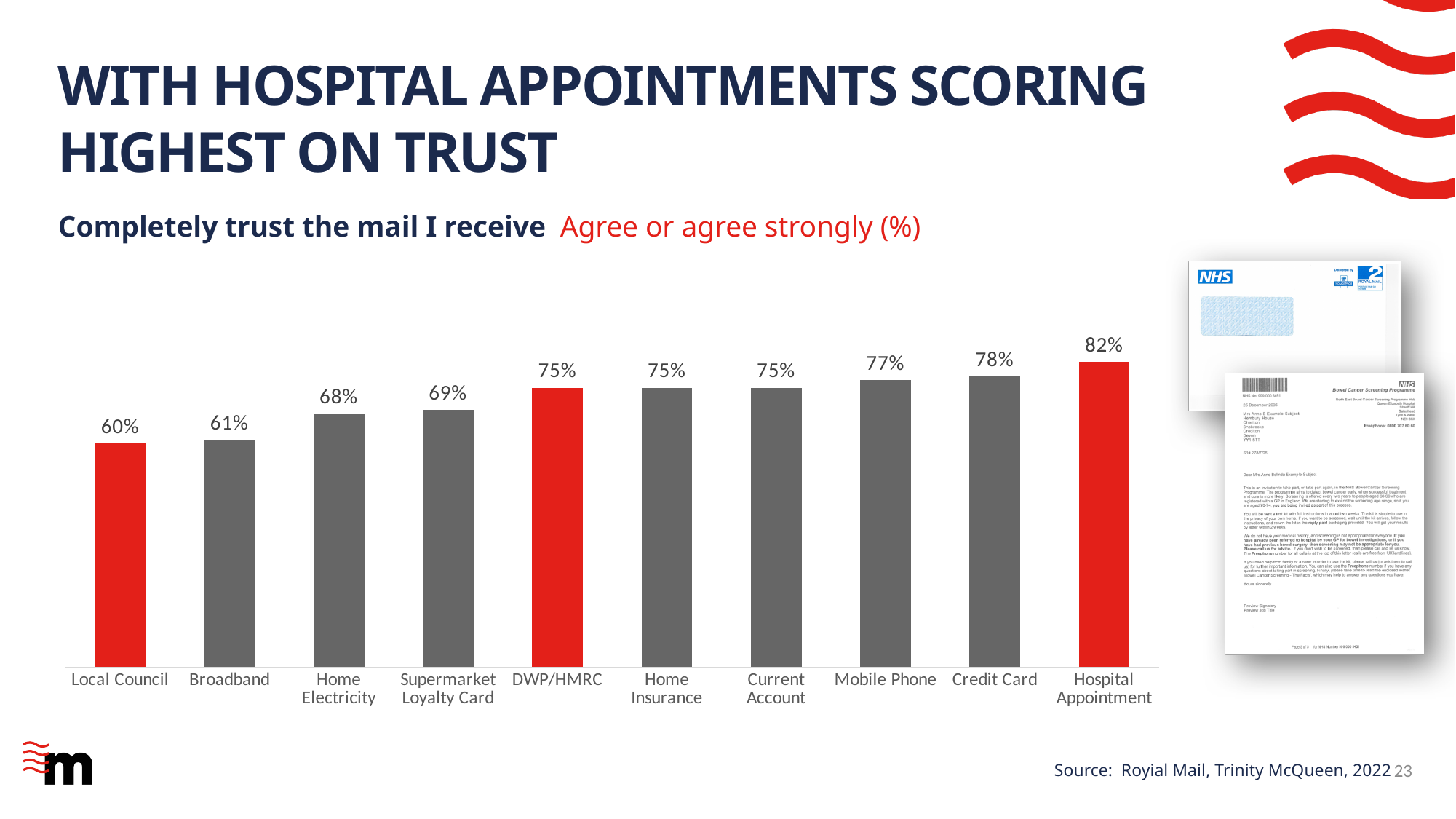
Which bars are coloured red in the chart? Local Council, DWP/HMRC and Hospital Appointment What is the difference between the values for Hospital Appointment and Local Council? 22% What is the value shown for Local Council? 60% How many categories are shown in the chart? 10 What is the value shown for Supermarket Loyalty Card? 69% Which category has the highest value? Hospital Appointment What percentage of respondents completely trust the mail they receive for Hospital Appointment? 82% Which has a higher value, Home Electricity or Credit Card? Credit Card What kind of chart is shown on the slide? Bar chart What is the difference between the values for Credit Card and Mobile Phone? 1% What is the value shown for DWP/HMRC? 75% Which category has the lowest value? Local Council